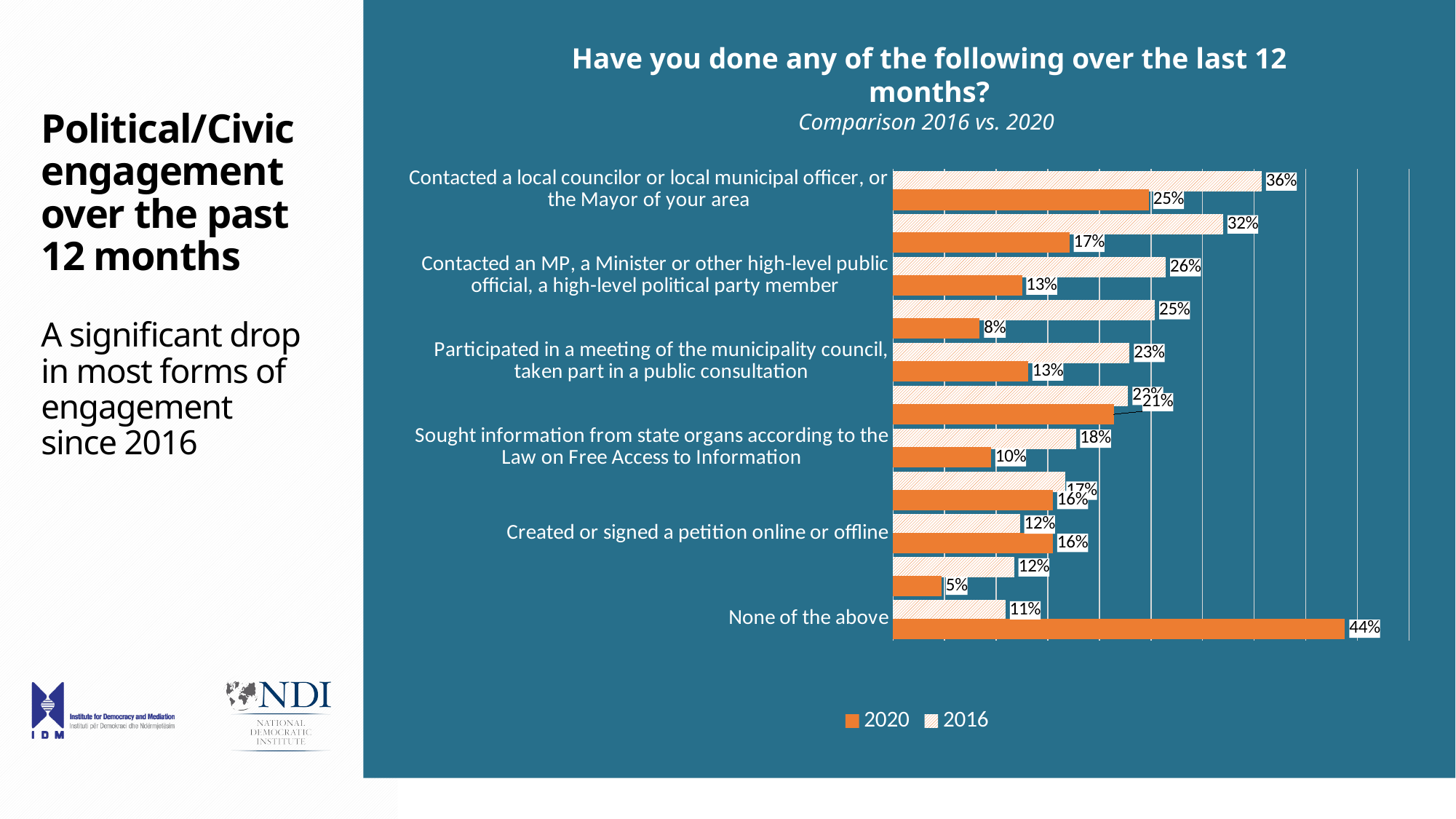
What is the 2016 value for "None of the above"? 11% What kind of chart is shown on the slide? Bar chart Which category has the highest 2020 value? None of the above What is the 2016 value for "Contacted a local councilor or local municipal officer, or the Mayor of your area"? 36% By how many percentage points did "Contacted an MP, a Minister or other high-level public official, a high-level political party member" fall from 2016 to 2020? 13 percentage points For "Created or signed a petition online or offline", which year has the larger value, 2016 or 2020? 2020 What is the 2016 value for "Participated in a meeting of the municipality council, taken part in a public consultation"? 23% Which colour represents the 2020 series in the legend? Orange What is the 2020 value for "Sought information from state organs according to the Law on Free Access to Information"? 10% How many series does the legend list? 2 What is the 2020 value for "Contacted a local councilor or local municipal officer, or the Mayor of your area"? 25% What is the 2020 value for "None of the above"? 44%